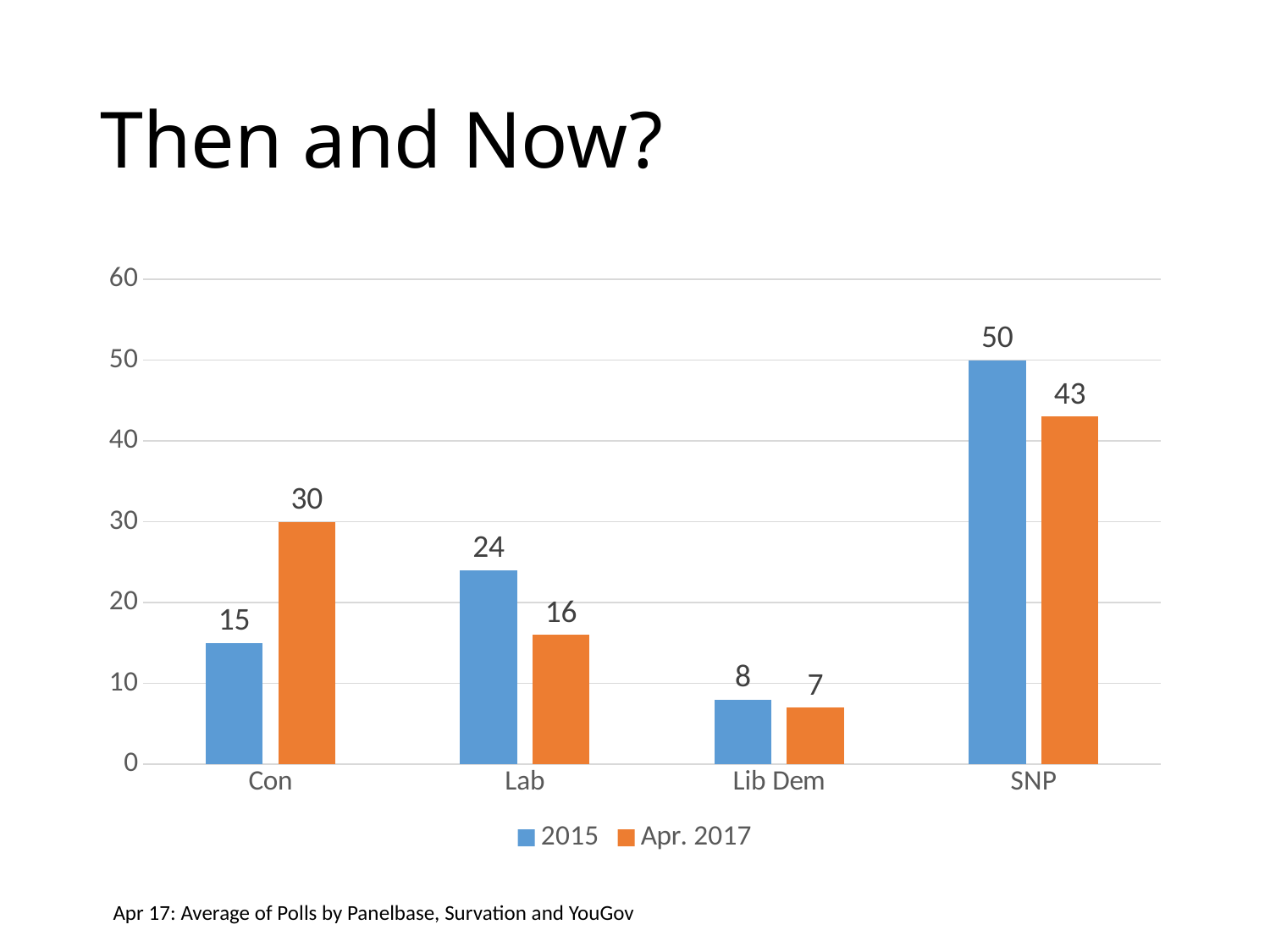
What is the difference between the 2015 and Apr. 2017 values for Lab? 8 What is the difference between the 2015 and Apr. 2017 values for Con? 15 What is the 2015 value for Con? 15 How many categories are shown on the x axis? 4 Which category has the lowest Apr. 2017 value? Lib Dem What is the Apr. 2017 value for SNP? 43 What is the title of the slide? Then and Now? Which category has the highest 2015 value? SNP What kind of chart is shown on the slide? Bar chart Which is larger for SNP, the 2015 value or the Apr. 2017 value? 2015 How many series does the legend list? 2 What is the Apr. 2017 value for Lab? 16